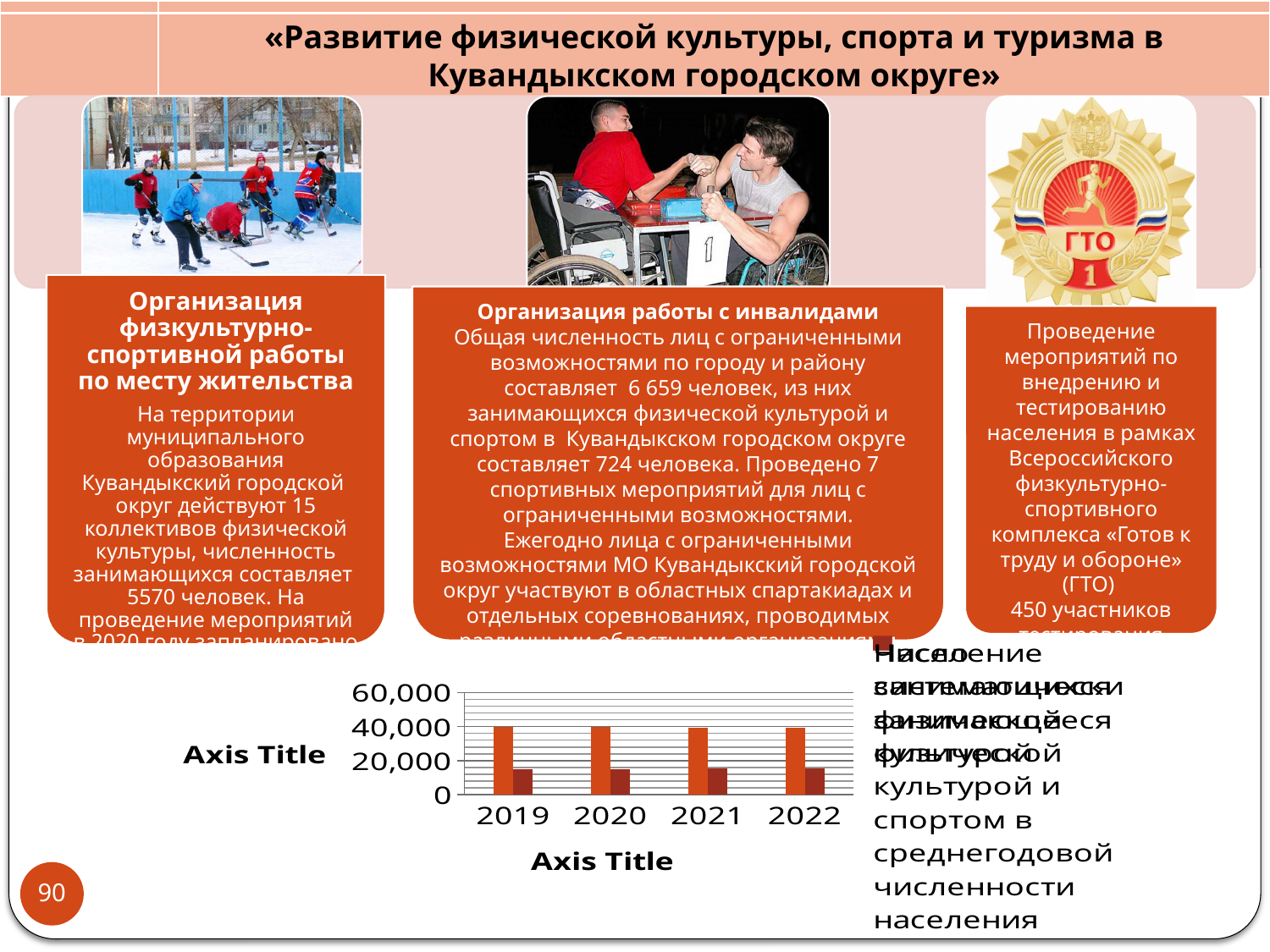
In 2020, which bar is larger: the left bar or the right bar? the left bar Is the value of the taller (left) bar for 2019 greater or less than 20,000? greater Is the value of the shorter (right) bar for 2021 greater or less than 20,000? less Is the value of the taller (left) bar for 2022 greater or less than 60,000? less What is the highest tick value shown on the vertical axis of the chart? 60,000 In 2022, which bar is larger: the left bar or the right bar? the left bar How many years are shown on the x axis of the chart? 4 Which years are shown on the x axis of the chart? 2019, 2020, 2021, 2022 How many bars are plotted for each year in the chart? 2 What kind of chart is shown at the bottom of the slide? bar chart